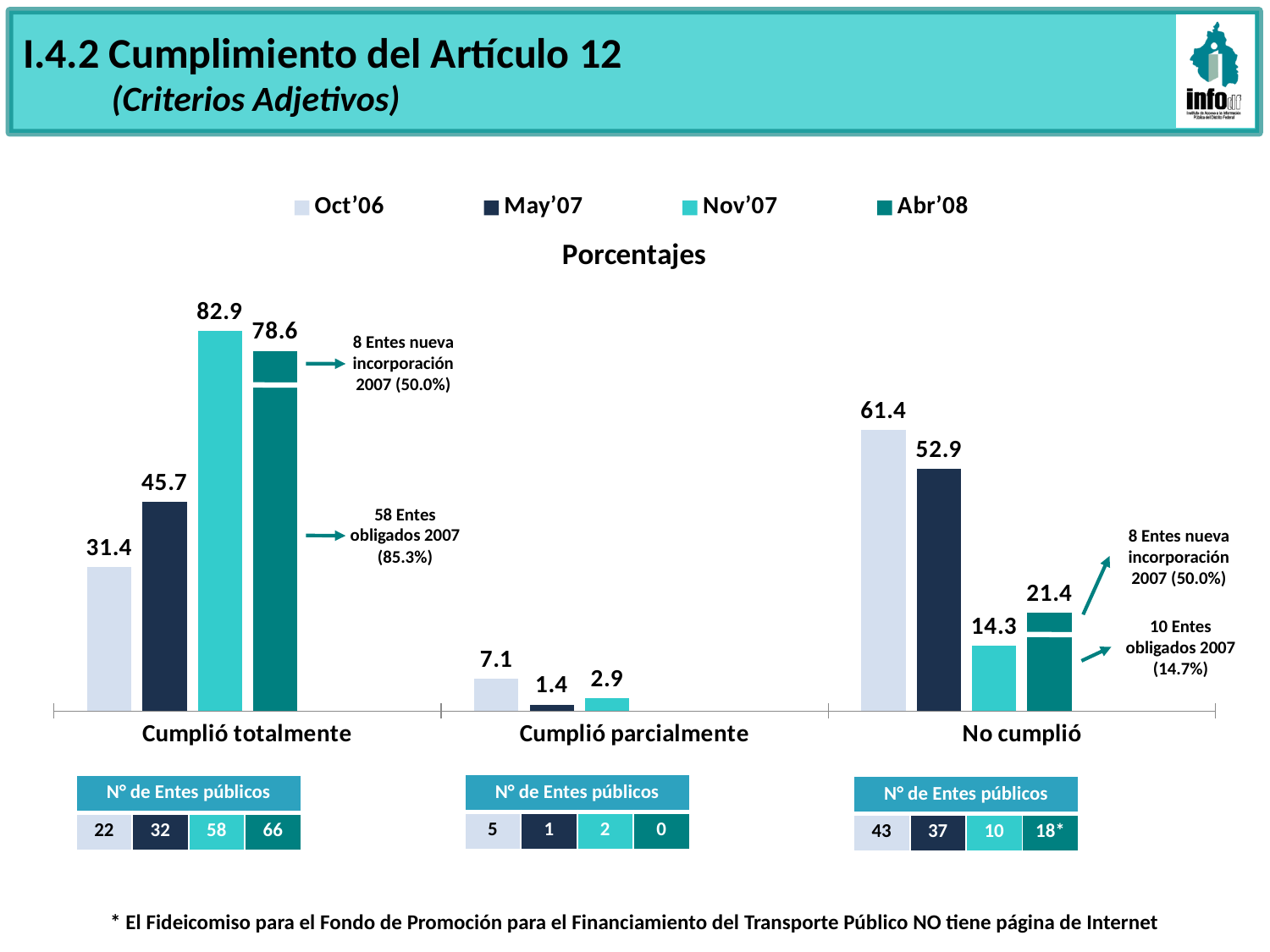
Which series has the lowest value in the No cumplió category? Nov'07 What is the value for Nov'07 in the Cumplió totalmente category? 82.9 What is the difference between the Nov'07 and Oct'06 values in the Cumplió totalmente category? 51.5 What is the value for Oct'06 in the No cumplió category? 61.4 What kind of chart is shown on the slide? Bar chart What is the value for Abr'08 in the No cumplió category? 21.4 How many categories are shown on the x axis? 3 What is the value for May'07 in the Cumplió parcialmente category? 1.4 What is the title shown above the chart? Porcentajes How many series does the legend list? 4 Which is larger in the No cumplió category: the Oct'06 value or the May'07 value? Oct'06 Which series has the highest value in the Cumplió totalmente category? Nov'07